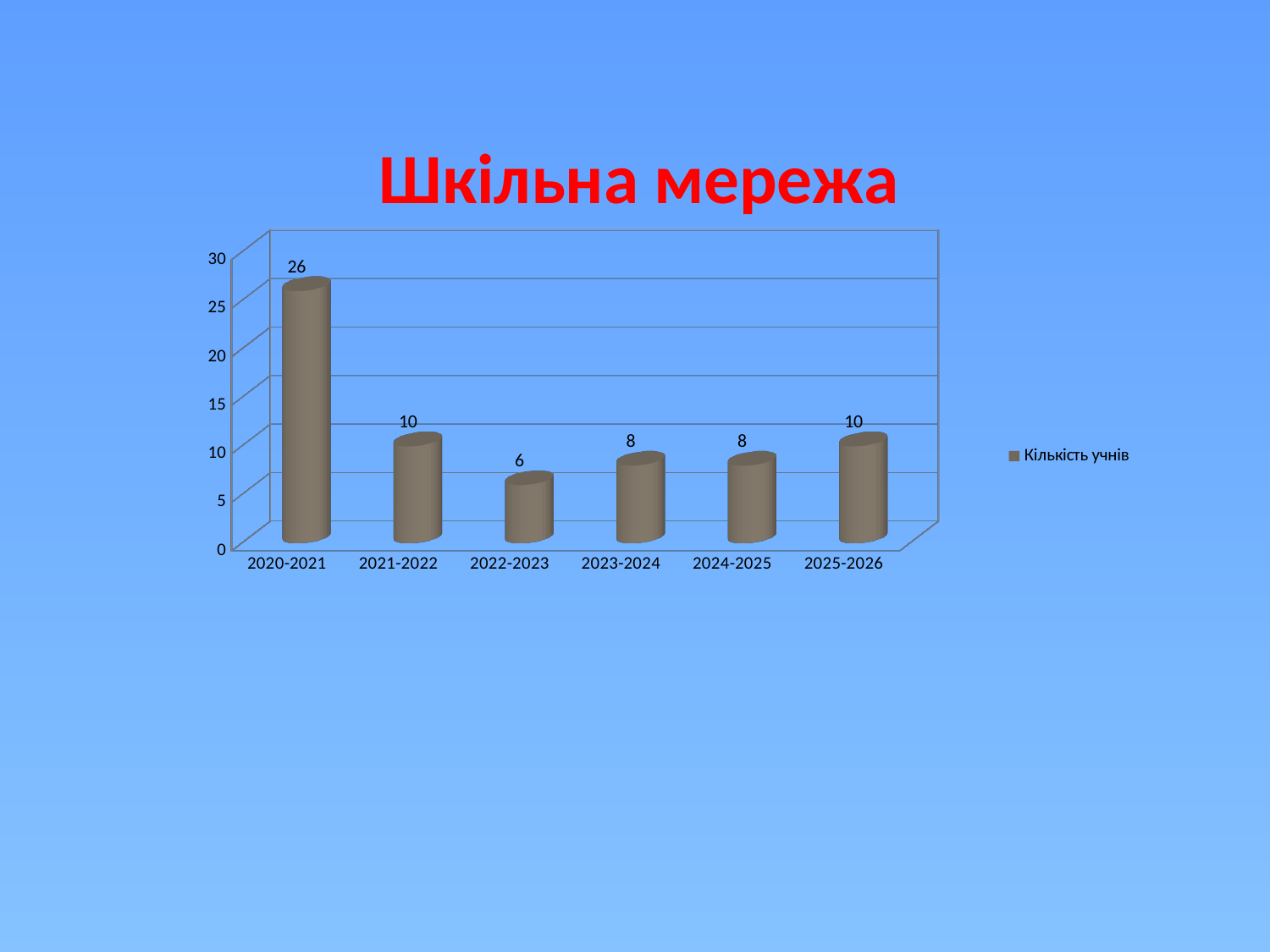
What is the value for 2022-2023? 6 What is the value for 2020-2021? 26 Which category has the lowest value? 2022-2023 What is the difference between the values for 2020-2021 and 2021-2022? 16 Is the value for 2020-2021 greater or less than 20? greater Which is larger, the value for 2021-2022 or the value for 2024-2025? 2021-2022 Which category has the highest value? 2020-2021 How many series does the legend list? 1 What kind of chart is shown on the slide? bar chart What is the difference between the values for 2023-2024 and 2022-2023? 2 What is the value for 2025-2026? 10 How many categories are shown on the x axis? 6